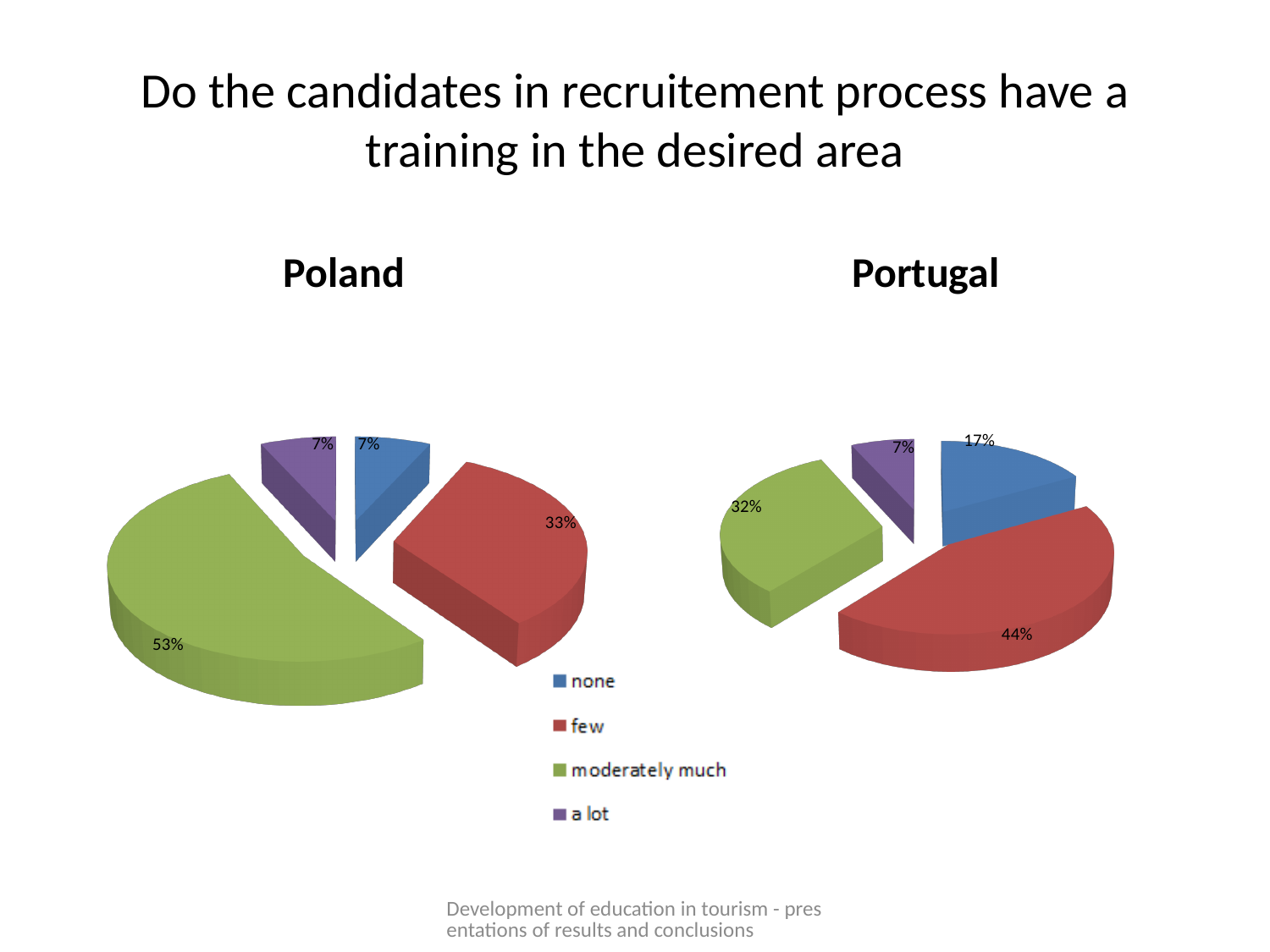
In the Portugal chart, what is the difference between the 'few' share and the 'moderately much' share? 12% In the Portugal chart, what share of responses is 'few'? 44% In the Portugal chart, which category has the smallest share? a lot In the Portugal chart, which category has the largest share? few How many categories does the legend list? 4 In the Poland chart, what share of responses is 'few'? 33% In the Portugal chart, what share of responses is 'none'? 17% What kind of chart is used for Poland and Portugal? pie chart In the Poland chart, what share of responses is 'moderately much'? 53% In the Poland chart, what is the difference between the 'moderately much' share and the 'few' share? 20% In the Poland chart, which category has the largest share? moderately much Which chart has the larger share for 'none', Poland or Portugal? Portugal